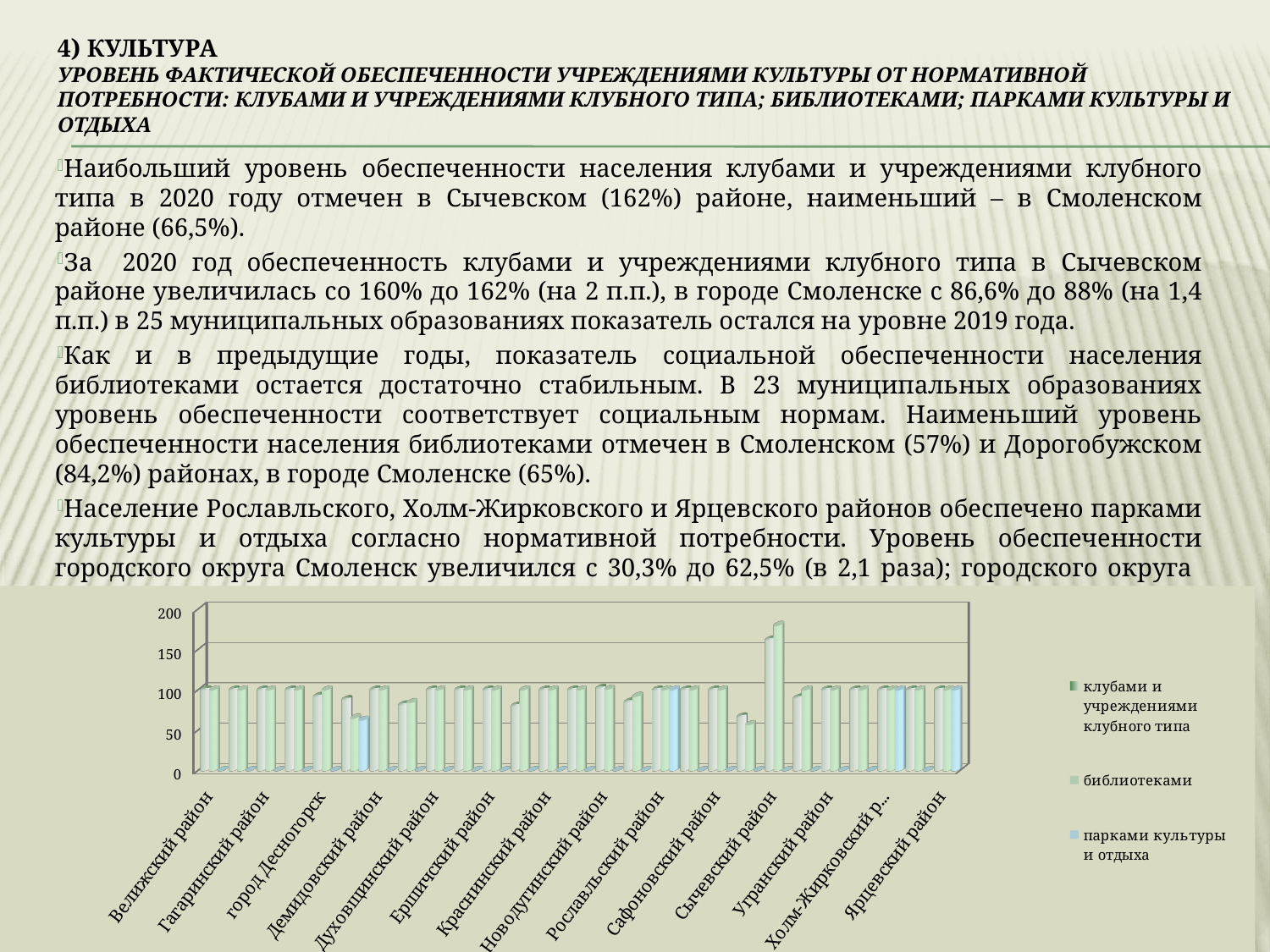
How many series does the chart legend list? 3 What is the highest tick value shown on the vertical axis of the chart? 200 Is the value for парками культуры и отдыха in Рославльский район greater or less than 50? greater What are the three series named in the chart legend? клубами и учреждениями клубного типа; библиотеками; парками культуры и отдыха What kind of chart is shown on the slide? bar chart Is the value for парками культуры и отдыха in Велижский район greater or less than 50? less Is the value for клубами и учреждениями клубного типа in Сычевский район greater or less than 150? greater Which category has the highest value for клубами и учреждениями клубного типа? Сычевский район Which has the larger value for клубами и учреждениями клубного типа: Сычевский район or Велижский район? Сычевский район